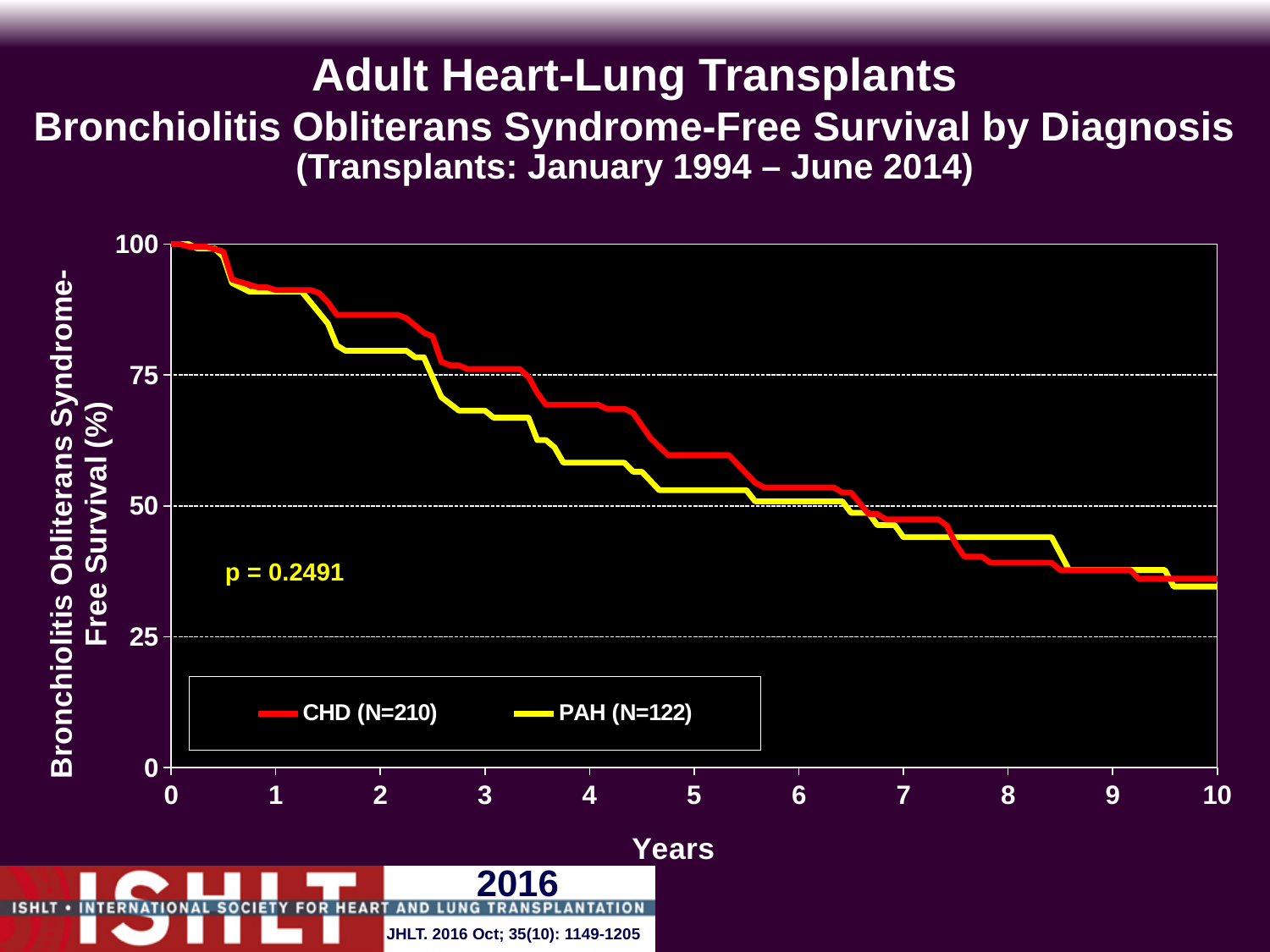
Do the survival curves rise or fall as years increase? fall Is the value for PAH at year 7 greater or less than 50? less What is the BOS-free survival value for both series at year 0? 100 Is the value for CHD at year 5 greater or less than 50? greater What is the p-value printed on the chart? p = 0.2491 What kind of chart is shown on the slide? line chart How many series does the legend list? 2 Is the value for PAH at year 3 greater or less than 75? less At year 3, which series has the higher BOS-free survival, CHD or PAH? CHD What are the two series named in the legend? CHD (N=210) and PAH (N=122) At year 8, which series has the higher BOS-free survival, CHD or PAH? PAH